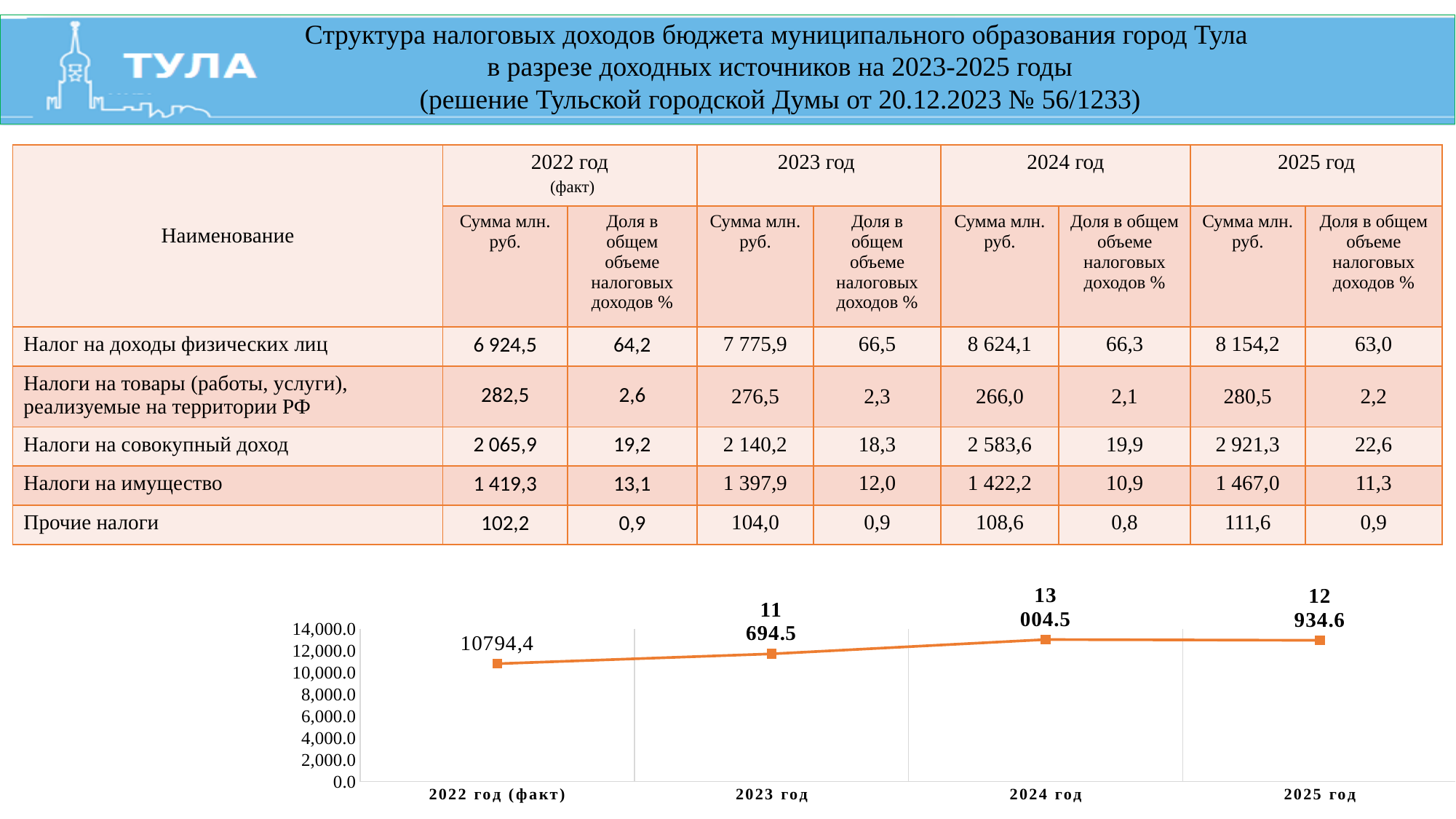
Which year has the highest value on the line chart? 2024 год On the line chart, is the value for 2022 год (факт) greater or less than 12,000.0? less What is the value plotted for 2023 год on the line chart? 11 694.5 What is the value plotted for 2025 год on the line chart? 12 934.6 What kind of chart is shown at the bottom of the slide? line chart What is the value plotted for 2024 год on the line chart? 13 004.5 Does the line on the chart rise or fall from 2022 год (факт) to 2024 год? rise How many data points are plotted on the line chart? 4 What is the value plotted for 2022 год (факт) on the line chart? 10794,4 On the line chart, is the value for 2023 год larger or smaller than the value for 2024 год? smaller What is the highest tick value shown on the vertical axis of the line chart? 14,000.0 Which year has the lowest value on the line chart? 2022 год (факт)